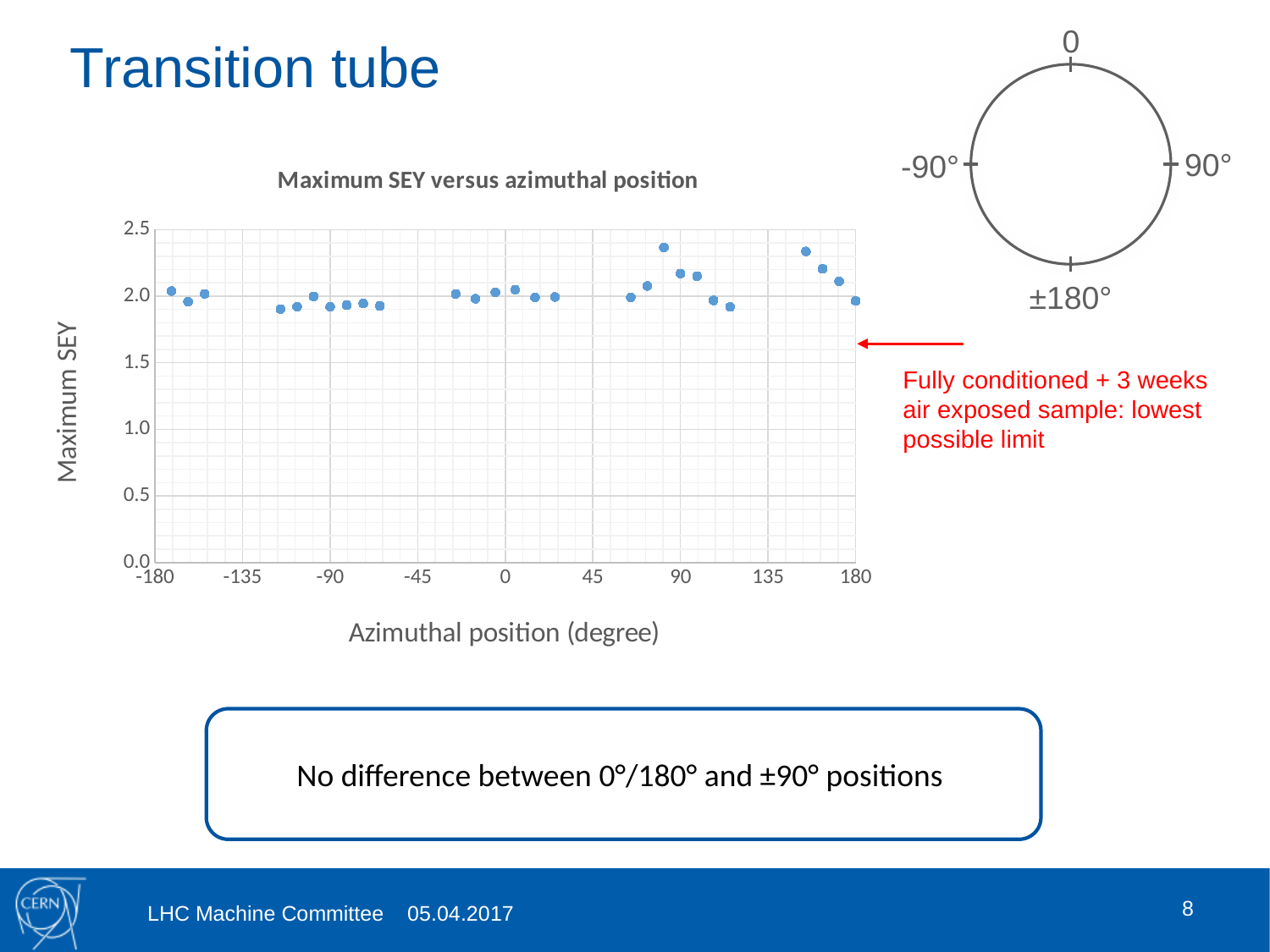
What is the title of the chart? Maximum SEY versus azimuthal position Is the maximum SEY value plotted near an azimuthal position of 80 degrees greater or less than 2.0? greater Which is larger, the maximum SEY value plotted near 80 degrees or the value plotted at 0 degrees? near 80 degrees Is the maximum SEY value plotted at an azimuthal position of -90 degrees greater or less than 1.0? greater What is the label of the x axis of the chart? Azimuthal position (degree) What kind of chart is shown on the slide? Scatter chart Is the highest maximum SEY value plotted on the chart greater or less than 2.5? less